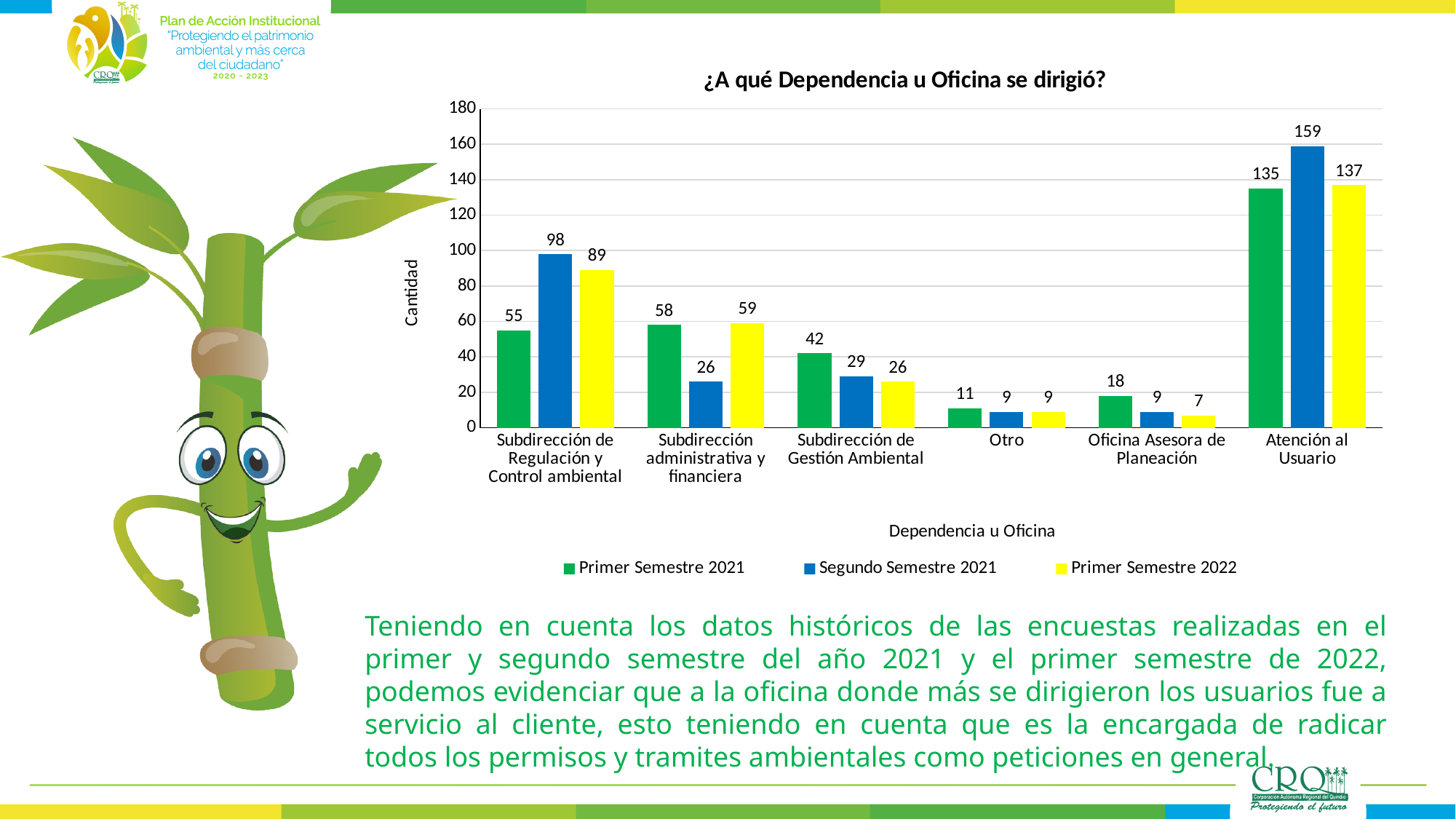
What is the title of the chart? ¿A qué Dependencia u Oficina se dirigió? What is the difference between the Segundo Semestre 2021 and Primer Semestre 2021 values for Atención al Usuario? 24 What kind of chart is shown on the slide? bar chart Which category has the highest value in the Primer Semestre 2021 series? Atención al Usuario How many categories are shown on the x axis? 6 How many series does the legend list? 3 Which category has the lowest value in the Primer Semestre 2022 series? Oficina Asesora de Planeación What is the value for Subdirección de Regulación y Control ambiental in the Primer Semestre 2022 series? 89 Is the Segundo Semestre 2021 value for Subdirección de Regulación y Control ambiental greater or less than 80? greater What is the value for Atención al Usuario in the Segundo Semestre 2021 series? 159 What is the value for Oficina Asesora de Planeación in the Primer Semestre 2021 series? 18 Which is larger for Subdirección administrativa y financiera: the Primer Semestre 2021 value or the Segundo Semestre 2021 value? Primer Semestre 2021